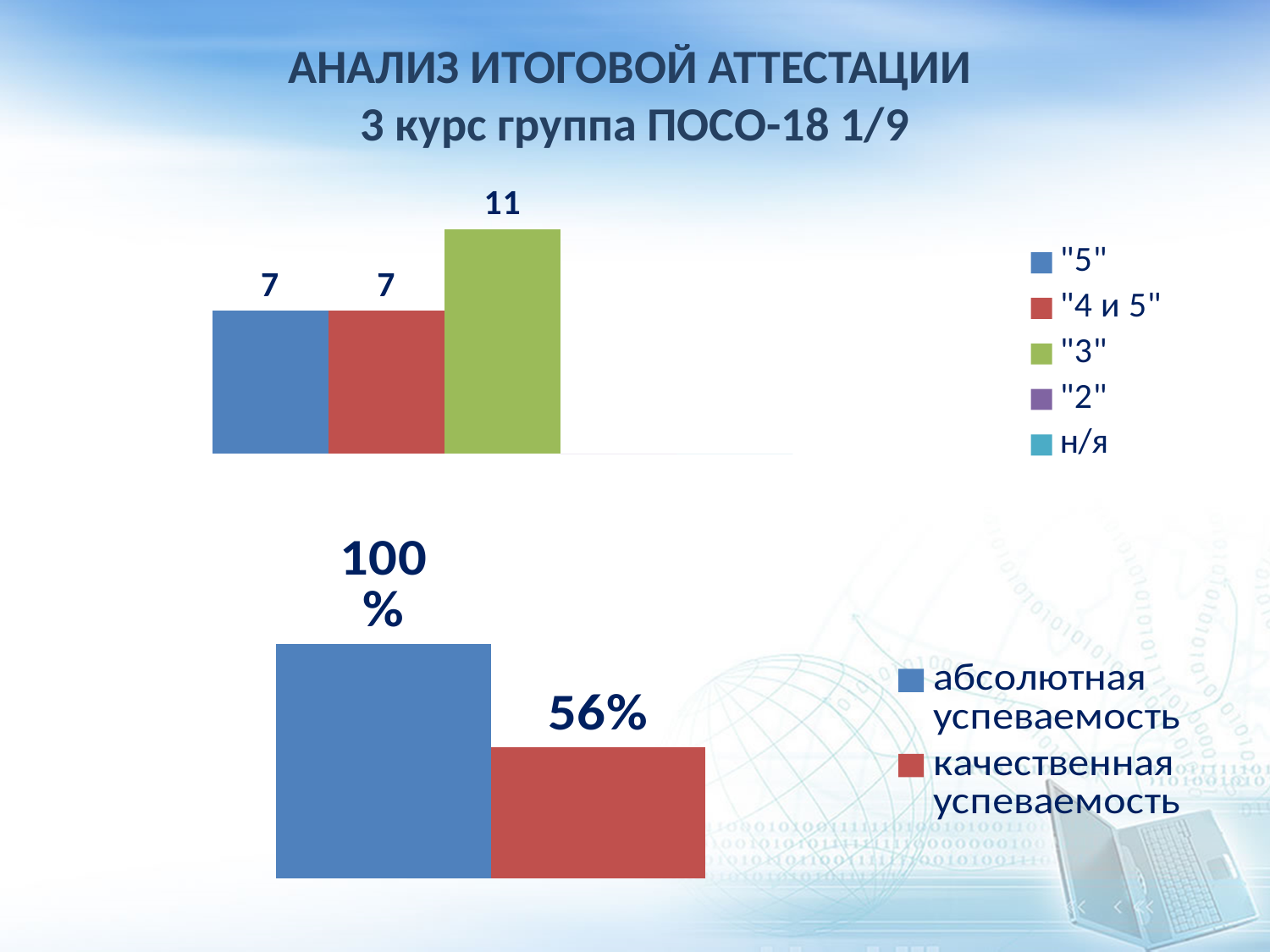
In the bottom chart, what is the difference between абсолютная успеваемость and качественная успеваемость? 44% In the top chart, what is the value for "5"? 7 In the top chart, which series has the highest value? "3" What kind of chart is the top chart? bar chart In the top chart, what is the value for "4 и 5"? 7 In the top chart, what is the difference between the value for "3" and the value for "5"? 4 In the bottom chart, which is larger: абсолютная успеваемость or качественная успеваемость? абсолютная успеваемость In the bottom chart, how many series does the legend list? 2 In the bottom chart, what is the value for абсолютная успеваемость? 100% In the top chart, how many series does the legend list? 5 In the bottom chart, what is the value for качественная успеваемость? 56% In the top chart, what is the value for "3"? 11